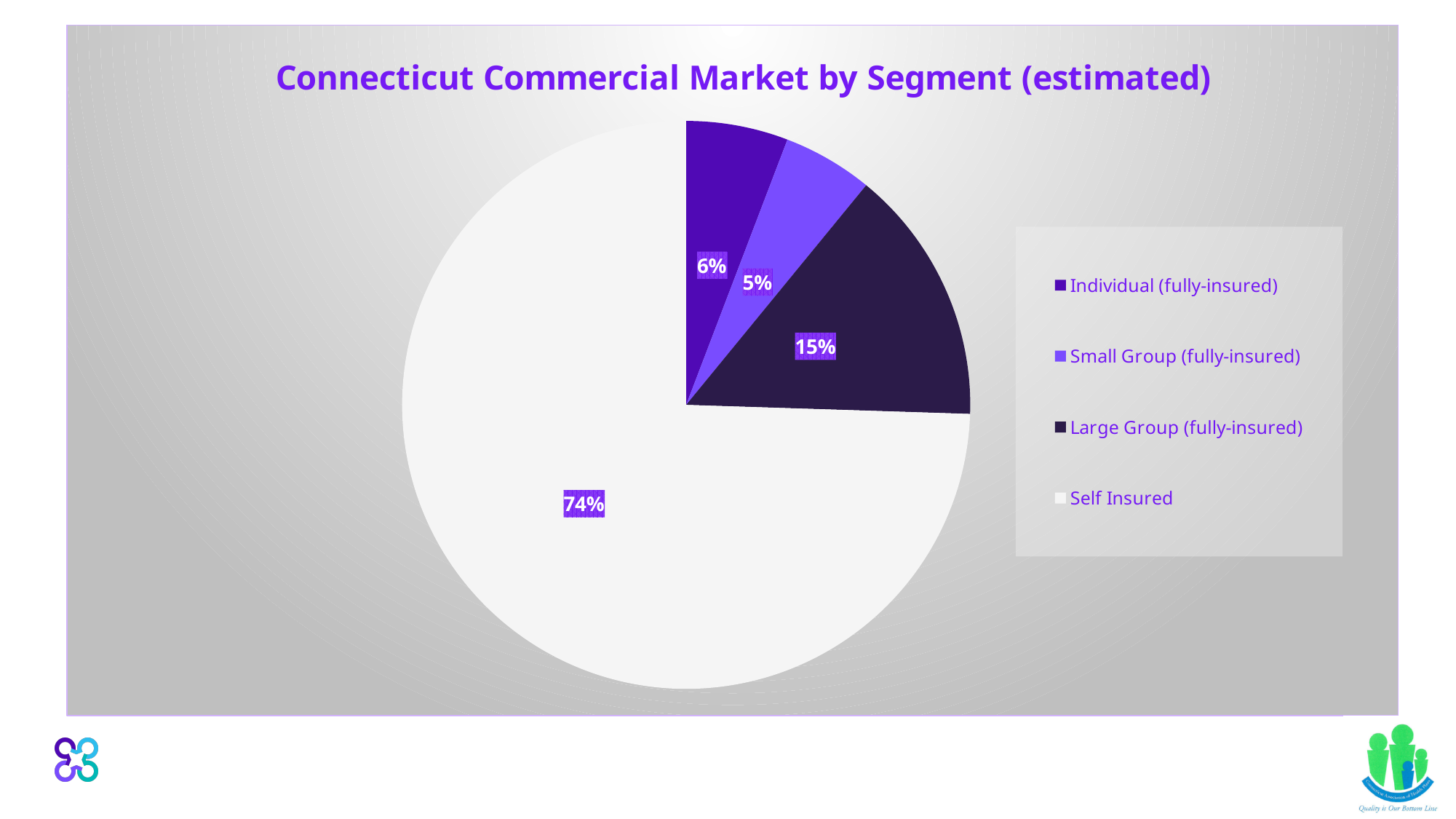
What share of the Connecticut commercial market is Self Insured? 74% What is the title of the chart? Connecticut Commercial Market by Segment (estimated) Which has a larger share, Individual (fully-insured) or Small Group (fully-insured)? Individual (fully-insured) What kind of chart is shown on the slide? Pie chart What is the combined share of the three fully-insured segments? 26% Which segment has the largest share of the market? Self Insured What share of the market is Small Group (fully-insured)? 5% Which segment has the smallest share of the market? Small Group (fully-insured) What is the difference in share between Self Insured and Large Group (fully-insured)? 59% What share of the market is Individual (fully-insured)? 6% How many segments are shown in the pie chart? 4 What share of the market is Large Group (fully-insured)? 15%